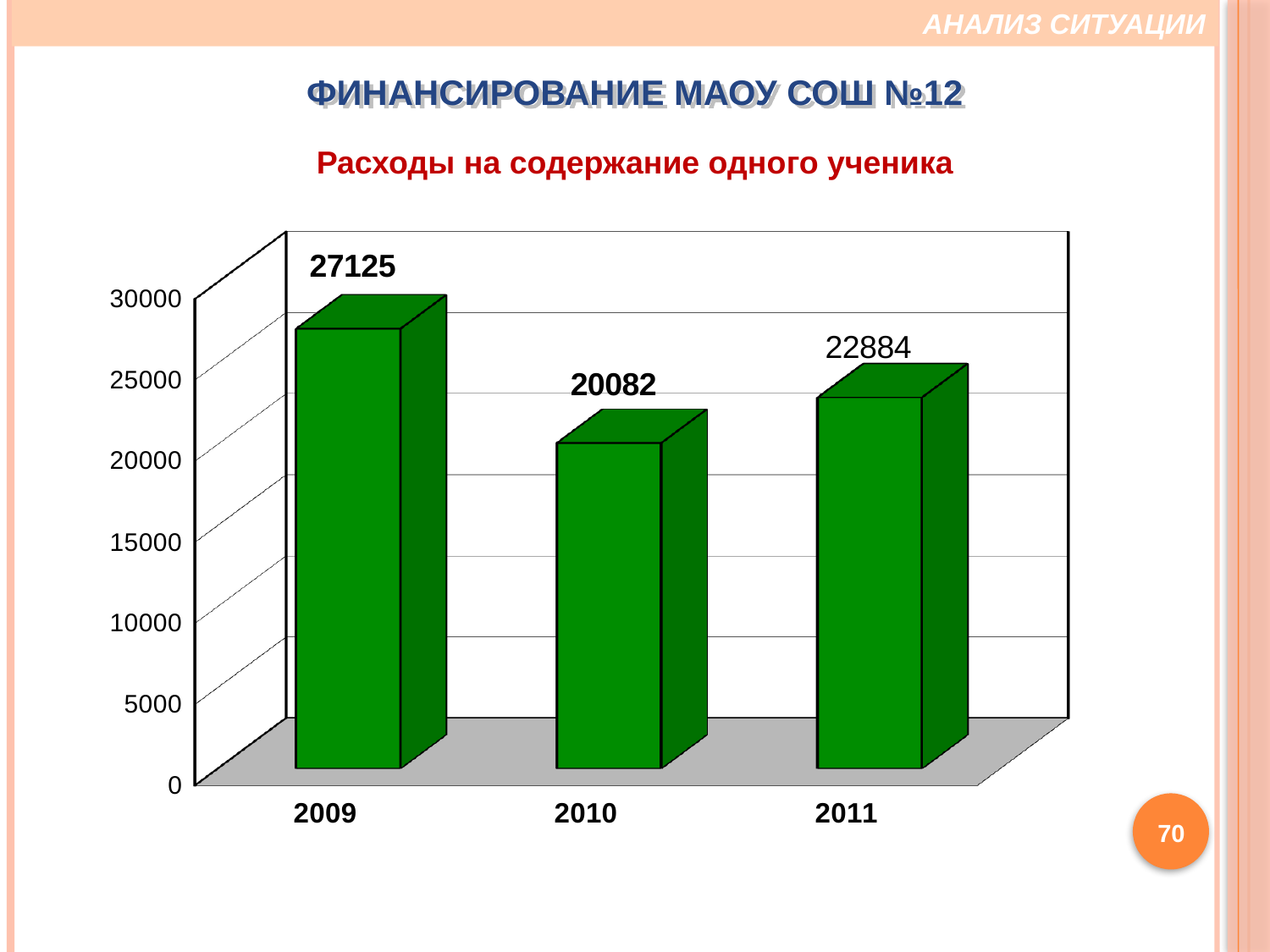
What kind of chart is shown on the slide? bar chart Which year has the highest value? 2009 What is the title of the chart? Расходы на содержание одного ученика What is the value for 2011? 22884 Which is larger, the value for 2011 or the value for 2010? 2011 Is the value for 2009 greater or less than 25000? greater What is the difference between the values for 2009 and 2010? 7043 Which year has the lowest value? 2010 How many years are shown on the x axis? 3 What is the value for 2009? 27125 What is the difference between the values for 2011 and 2010? 2802 What is the value for 2010? 20082